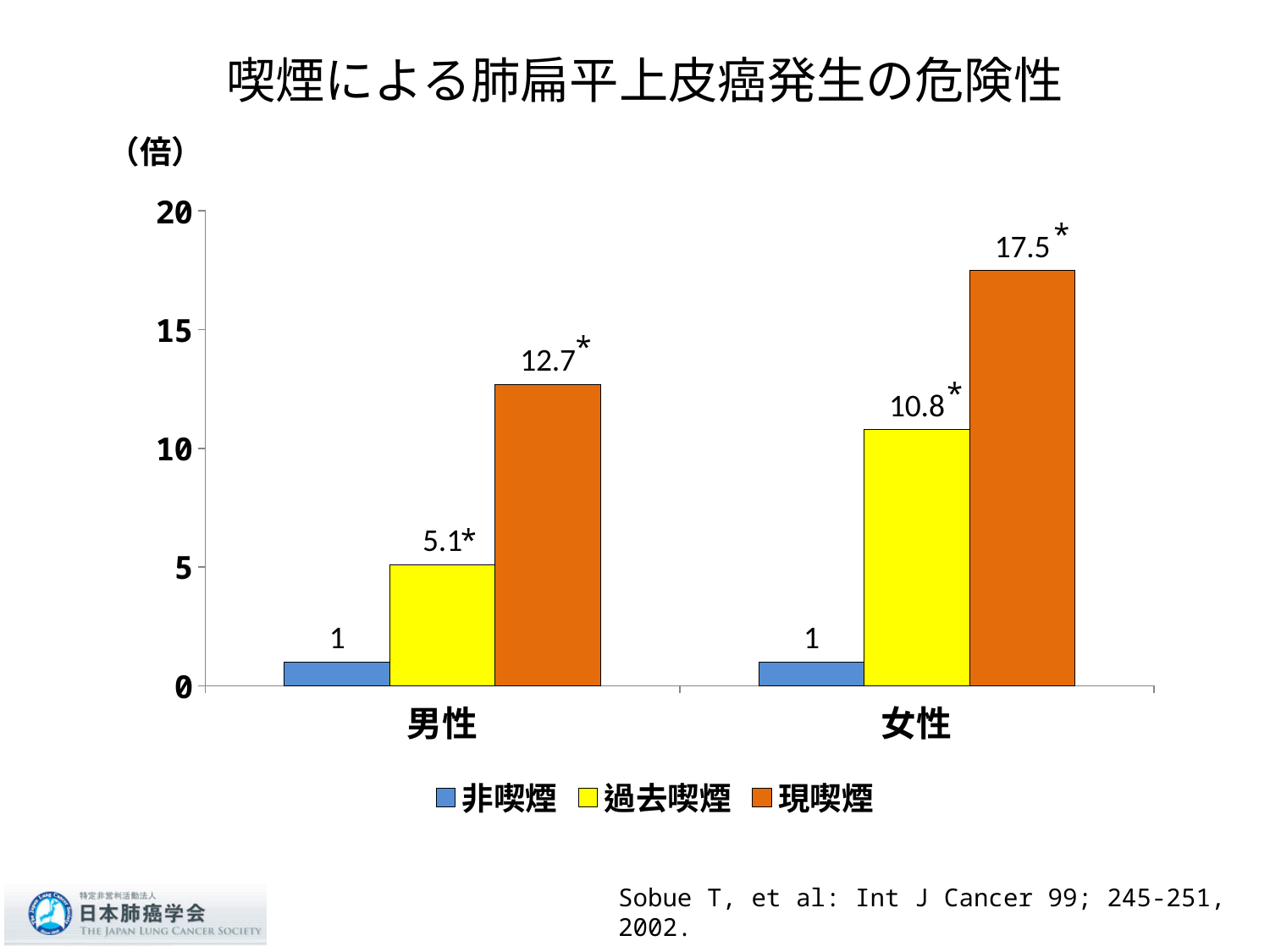
What is the value for 過去喫煙 in the 女性 category? 10.8 What is the value for 非喫煙 in the 男性 category? 1 How many series does the legend list? 3 What is the value for 現喫煙 in the 男性 category? 12.7 What is the difference between the 現喫煙 values for 女性 and 男性? 4.8 Which series has the lowest value in the 男性 category? 非喫煙 What is the difference between the 過去喫煙 values for 女性 and 男性? 5.7 Which is larger: the 過去喫煙 value for 女性 or the 現喫煙 value for 男性? 現喫煙 value for 男性 How many categories are shown on the x axis? 2 What is the value for 現喫煙 in the 女性 category? 17.5 Which series has the highest value in the 女性 category? 現喫煙 What kind of chart is shown on the slide? Bar chart